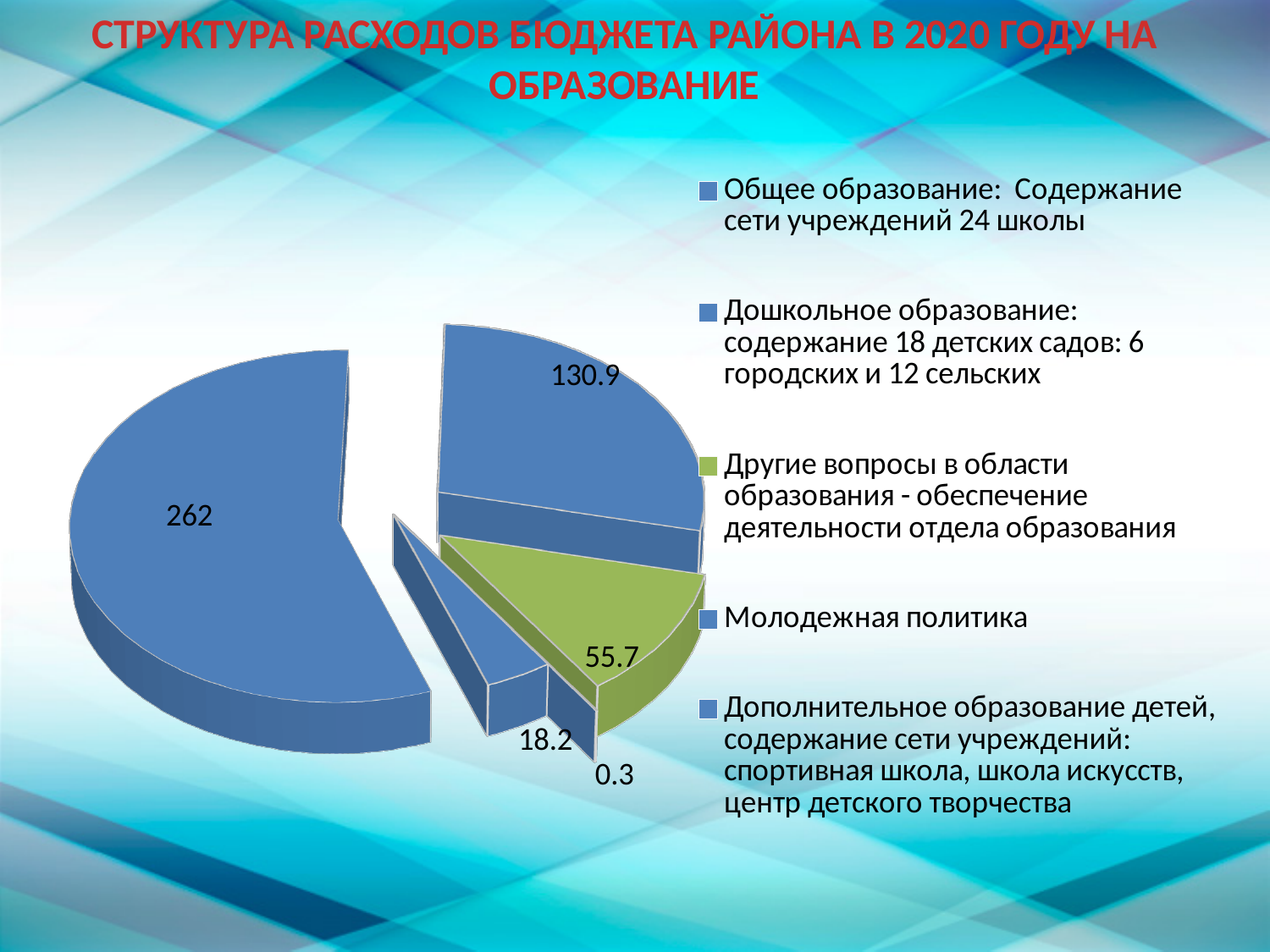
What is the difference between the largest slice (262) and the slice labelled 130.9? 131.1 How many slices does the pie chart have? 5 Which is larger: the slice labelled 55.7 or the slice labelled 18.2? 55.7 What value is shown for Дополнительное образование детей? 18.2 Which legend entry is shown in green? Другие вопросы в области образования - обеспечение деятельности отдела образования What is the value of the smallest slice of the pie chart? 0.3 How many entries does the legend list? 5 What is the value of the largest slice of the pie chart? 262 What value is shown for Дошкольное образование? 130.9 What value is shown for the green slice (Другие вопросы в области образования)? 55.7 What kind of chart is shown on the slide? Pie chart What is the title of the chart on the slide? СТРУКТУРА РАСХОДОВ БЮДЖЕТА РАЙОНА В 2020 ГОДУ НА ОБРАЗОВАНИЕ